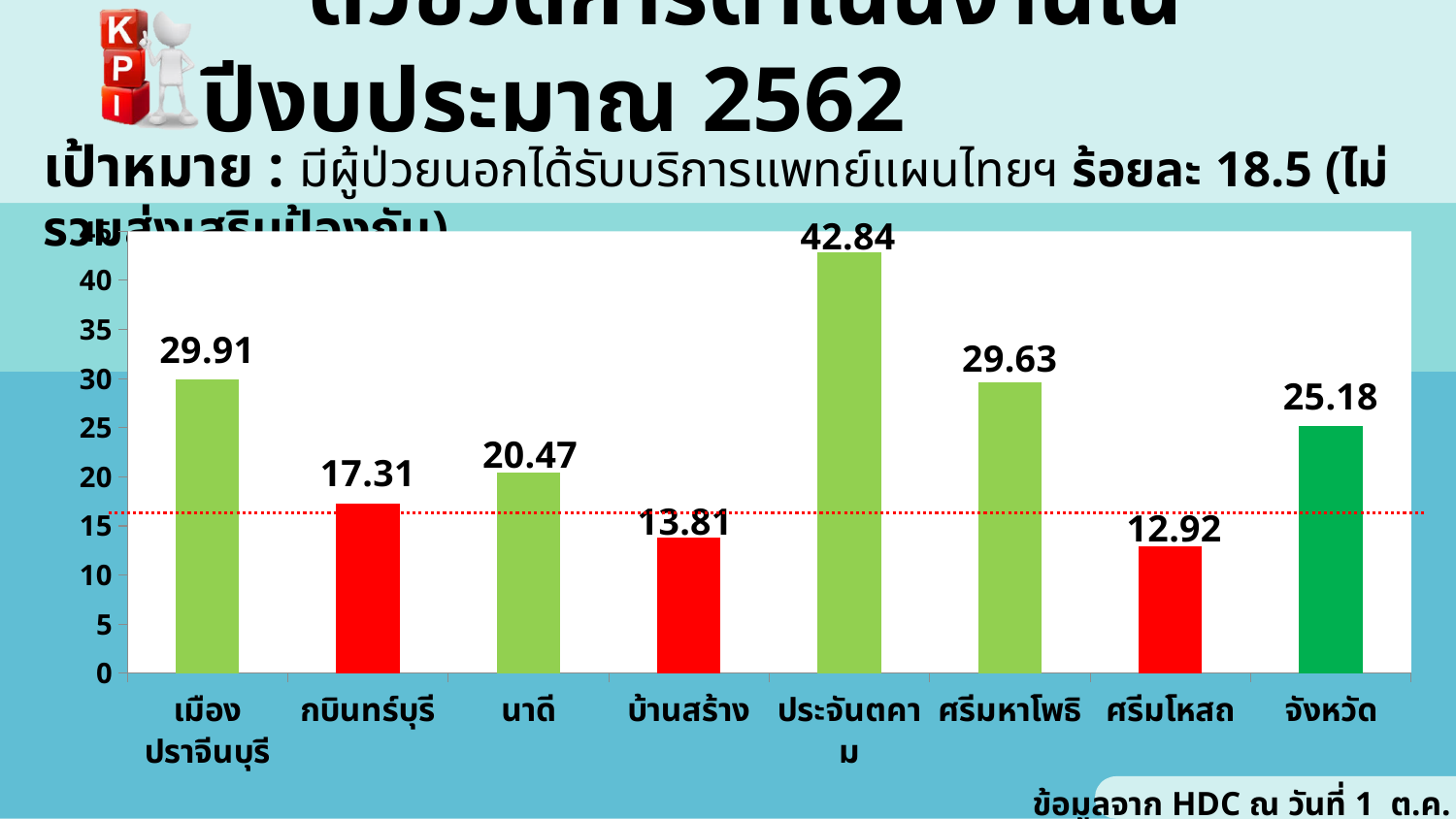
What is the value for ศรีมโหสถ? 12.92 Is the value for ศรีมหาโพธิ greater or less than 25? greater Which category has the highest value? ประจันตคาม What is the value for นาดี? 20.47 What is the value for จังหวัด? 25.18 Which category has the lowest value? ศรีมโหสถ What is the difference between the values for ประจันตคาม and ศรีมโหสถ? 29.92 What is the value for ประจันตคาม? 42.84 What is the difference between the values for เมืองปราจีนบุรี and กบินทร์บุรี? 12.6 Which is larger, the value for นาดี or the value for บ้านสร้าง? นาดี What kind of chart is shown on the slide? bar chart How many categories are shown on the x axis? 8